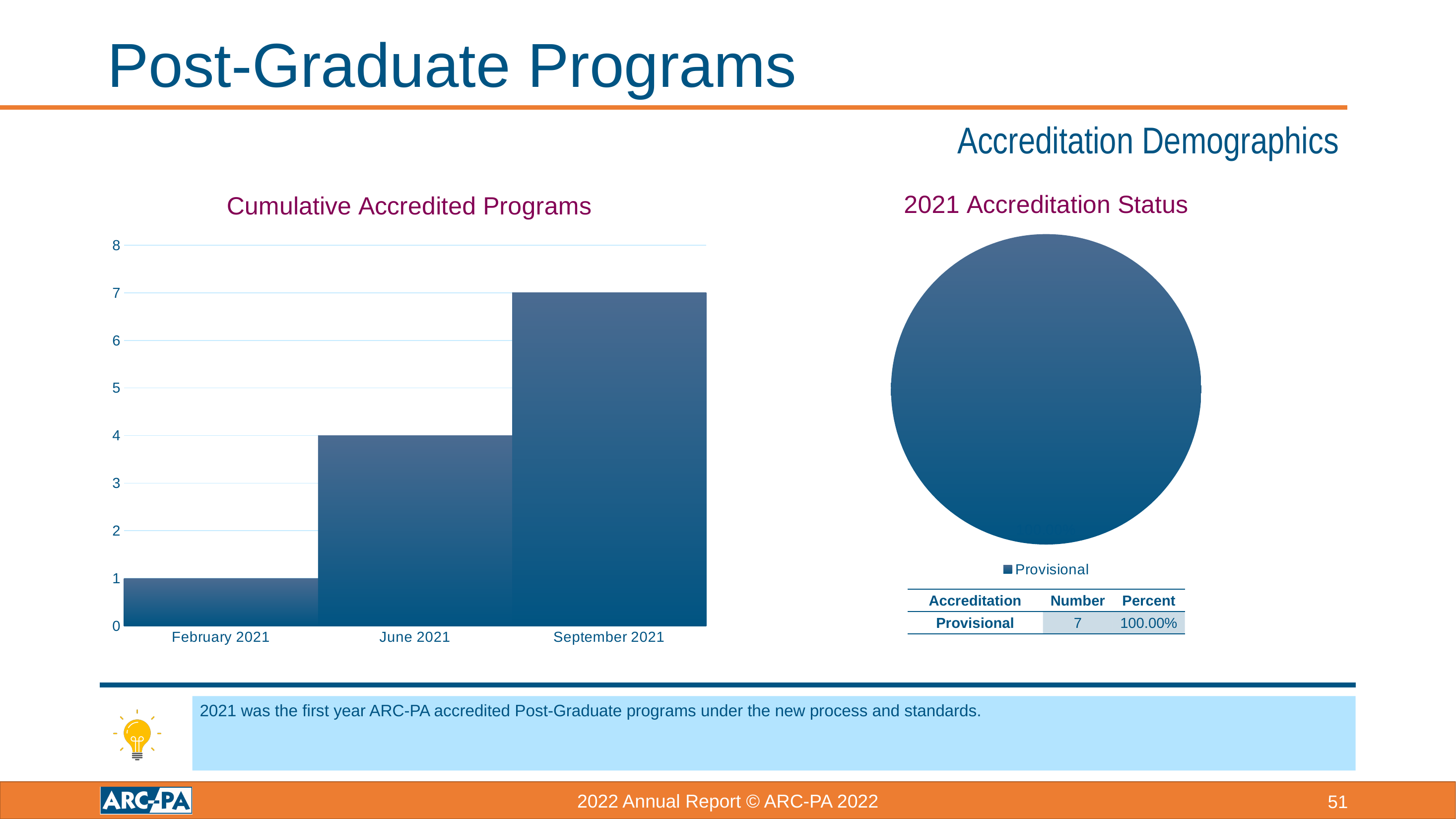
What kind of chart is the Cumulative Accredited Programs chart? bar chart In the 2021 Accreditation Status pie chart, what share does Provisional have? 100.00% How many entries does the legend of the 2021 Accreditation Status chart list? 1 In the Cumulative Accredited Programs chart, what is the value for September 2021? 7 In the Cumulative Accredited Programs chart, what is the value for June 2021? 4 In the Cumulative Accredited Programs chart, do the values rise or fall from February 2021 to September 2021? rise In the Cumulative Accredited Programs chart, how many categories are shown on the x axis? 3 In the Cumulative Accredited Programs chart, which category has the highest value? September 2021 In the Cumulative Accredited Programs chart, which category has the lowest value? February 2021 In the Cumulative Accredited Programs chart, which is larger, the value for June 2021 or February 2021? June 2021 In the Cumulative Accredited Programs chart, what is the value for February 2021? 1 In the Cumulative Accredited Programs chart, what is the difference between the values for September 2021 and June 2021? 3